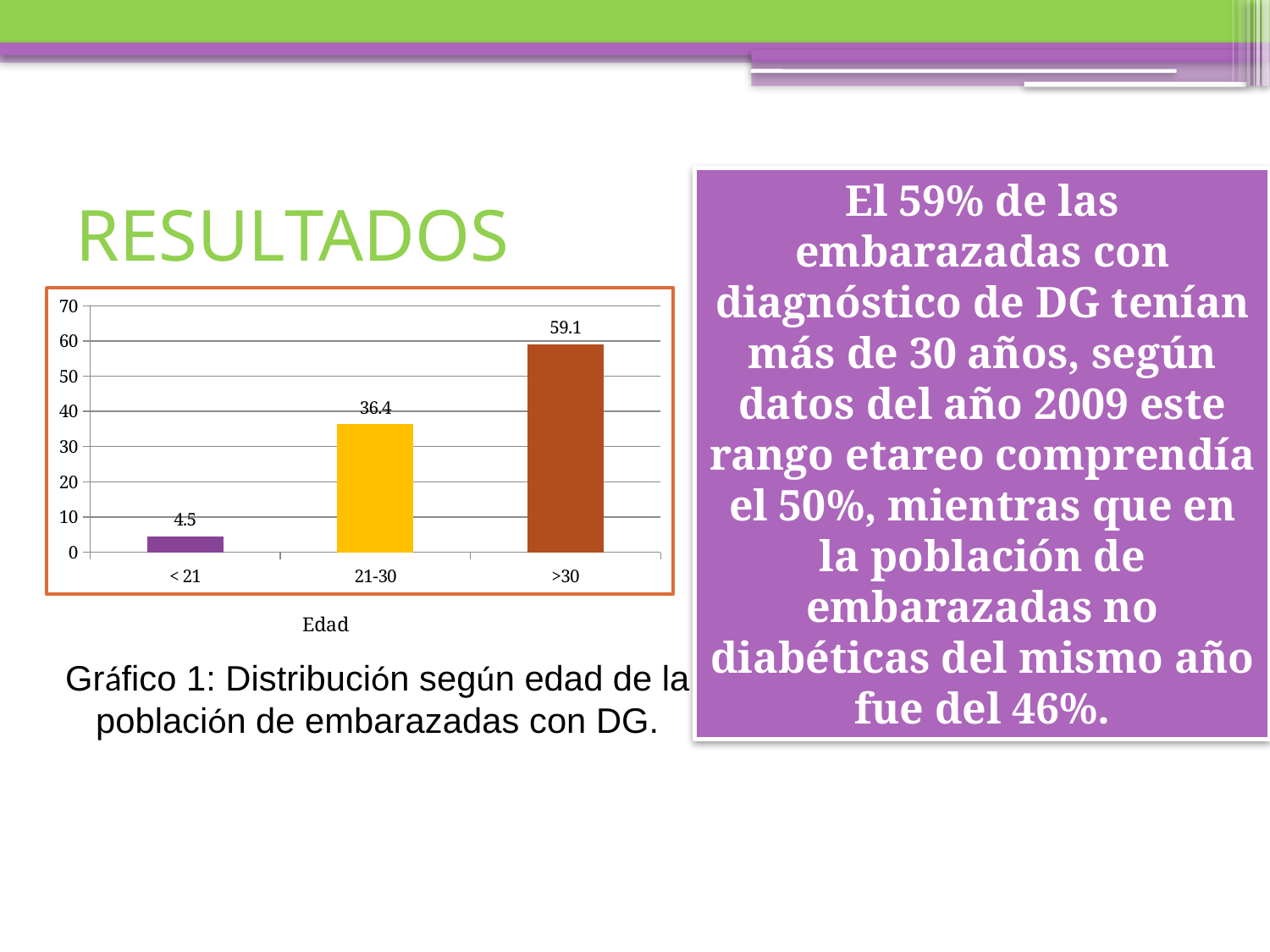
What is the difference between the values for 21-30 and < 21? 31.9 Which age group has the highest value? >30 What kind of chart is shown? bar chart Is the value for >30 greater or less than 50? greater Which age group has the lowest value? < 21 What is the value for the 21-30 age group? 36.4 What is the value for the >30 age group? 59.1 What is the difference between the values for >30 and 21-30? 22.7 How many age groups are shown on the x axis? 3 What is the value for the < 21 age group? 4.5 Which is larger, the value for 21-30 or the value for < 21? 21-30 Do the values rise or fall from left to right along the x axis? rise